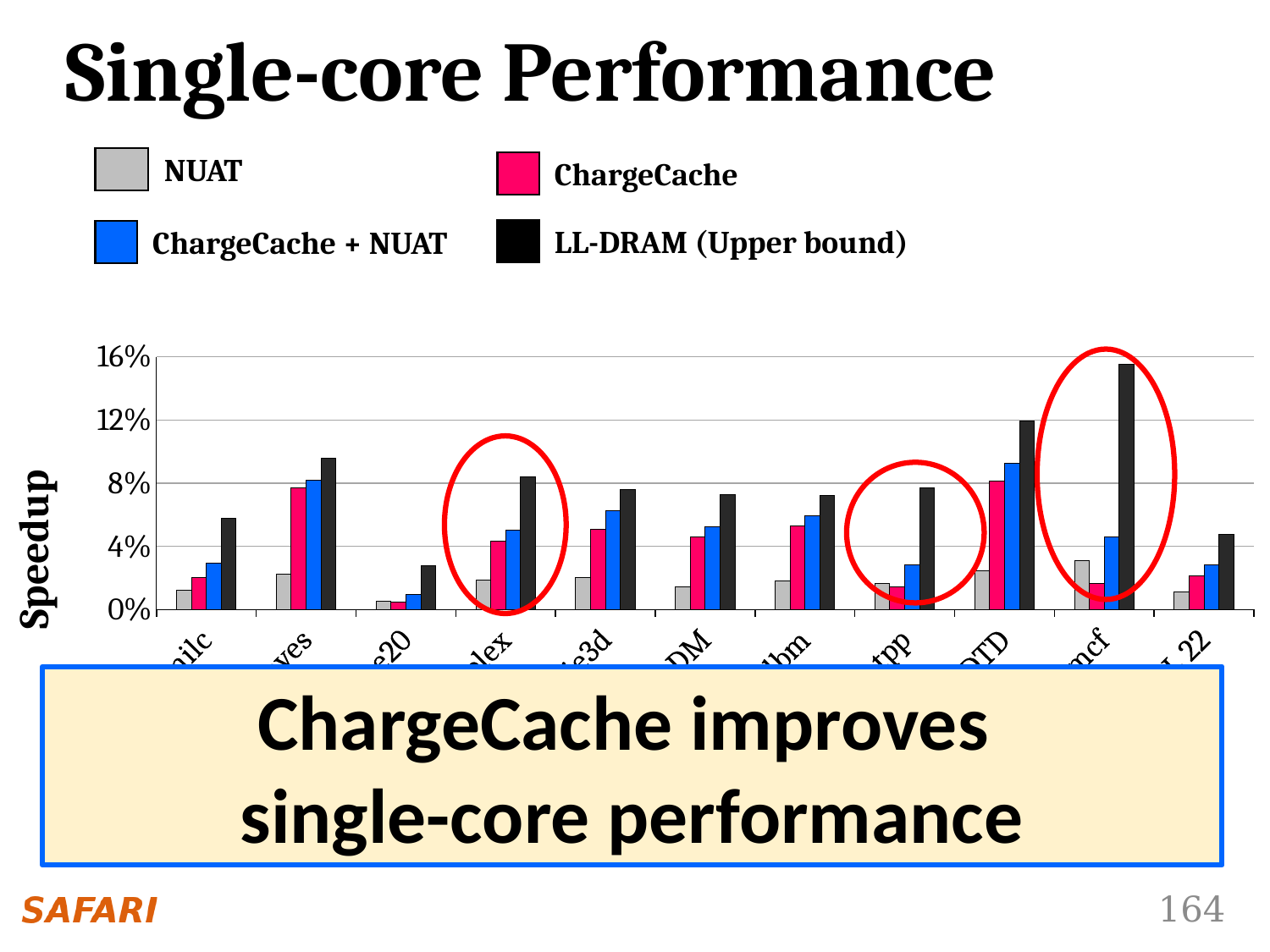
Which series is shown in black in the legend? LL-DRAM (Upper bound) How many series does the legend list? 4 Is the LL-DRAM (Upper bound) value for the third group from the left greater or less than 4%? less How many benchmark groups are plotted along the x axis? 11 Is the LL-DRAM (Upper bound) value for the second group from the right greater or less than 12%? greater What is the label of the y axis? Speedup In the second group from the right, which is larger: the NUAT bar or the ChargeCache bar? NUAT Which benchmark group has the highest LL-DRAM (Upper bound) bar? the second group from the right Is the LL-DRAM (Upper bound) value for the leftmost group greater or less than 8%? less Which series has the tallest bar in every benchmark group? LL-DRAM (Upper bound) What kind of chart is shown on the slide? bar chart In the leftmost group, which is larger: the NUAT bar or the ChargeCache + NUAT bar? ChargeCache + NUAT